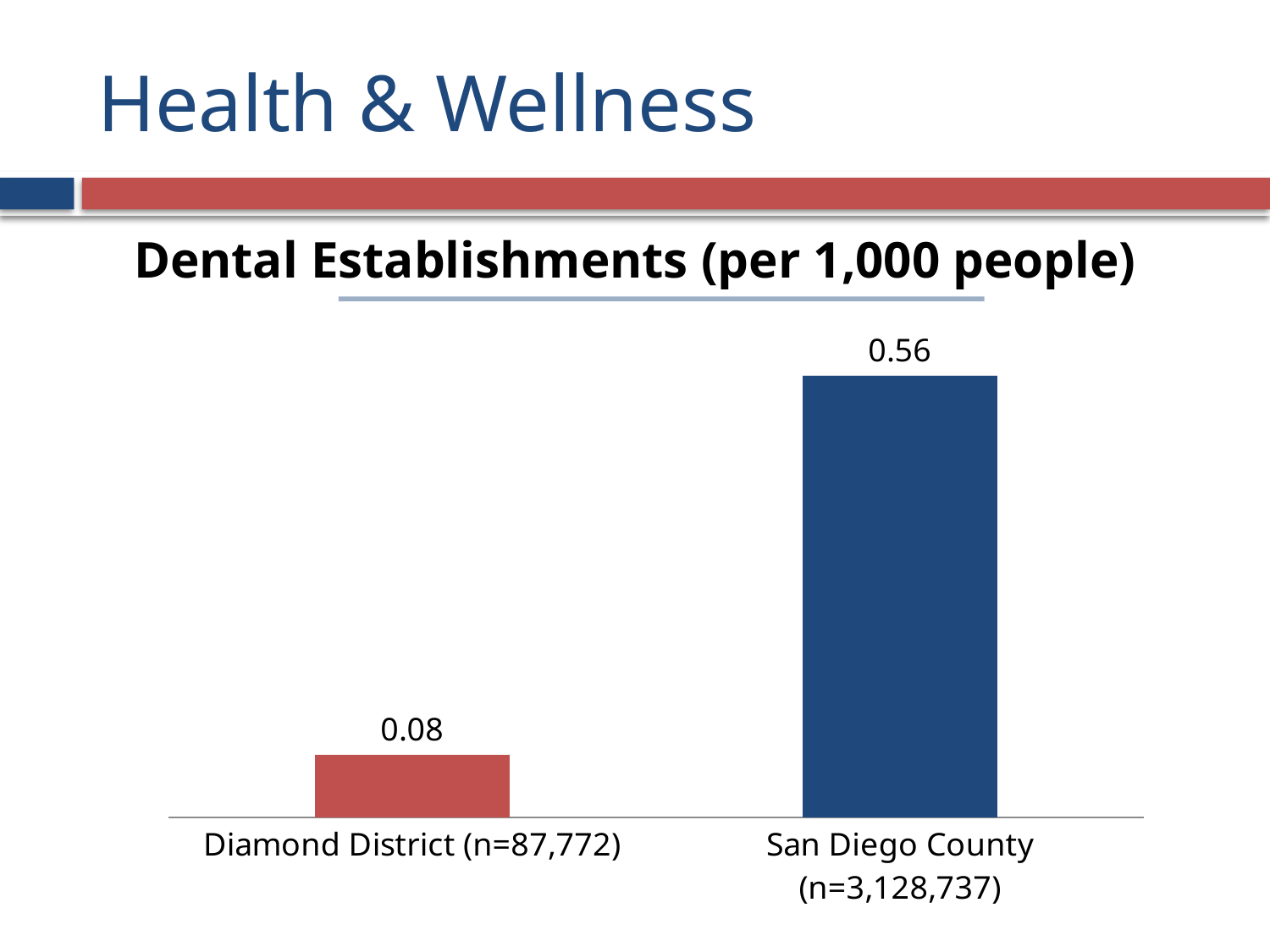
What is the value for San Diego County (n=3,128,737)? 0.56 Which is larger, the value for Diamond District or the value for San Diego County? San Diego County Which category has the lowest value? Diamond District (n=87,772) Which category has the highest value? San Diego County (n=3,128,737) How many categories are shown in the chart? 2 What kind of chart is shown on the slide? Bar chart What colour is the bar for Diamond District? Red What is the value for Diamond District (n=87,772)? 0.08 What is the difference between the values for San Diego County and Diamond District? 0.48 What is the title of the chart? Dental Establishments (per 1,000 people)